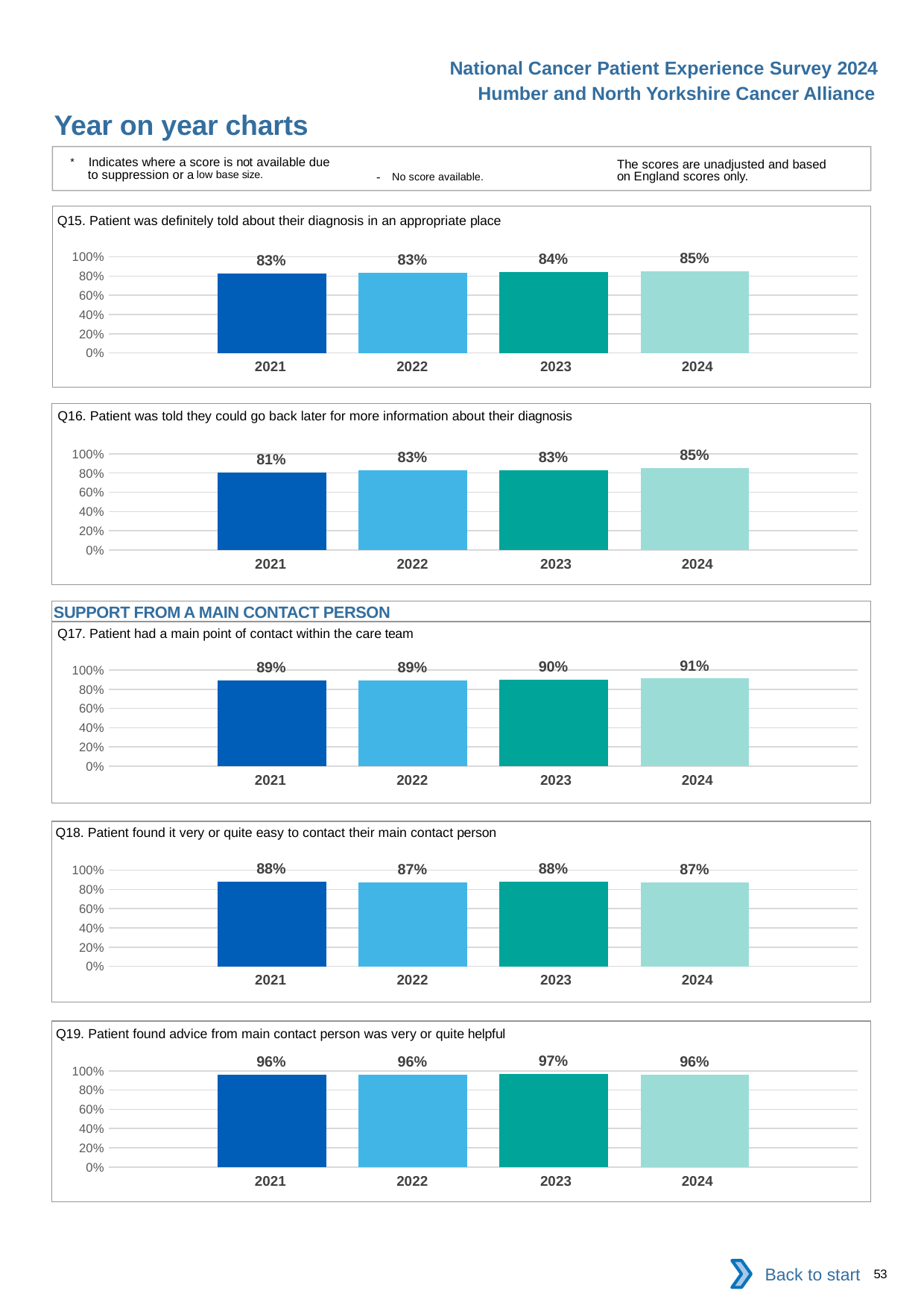
In the Q19 chart, which year has the highest value? 2023 In the Q16 chart, which year has the highest value? 2024 In the Q17 chart, what is the value for 2023? 90% In the Q16 chart, what is the difference between the 2024 and 2021 values? 4 percentage points In the Q15 chart, what is the value for 2024? 85% In the Q17 chart, which year has the highest value? 2024 In the Q16 chart, do the values generally rise or fall from 2021 to 2024? Rise In the Q16 chart, what is the value for 2021? 81% How many years are shown on the x axis of the Q15 chart? 4 In the Q19 chart, what is the difference between the 2023 and 2024 values? 1 percentage point In the Q18 chart, what is the value for 2022? 87% What kind of chart is the Q18 chart? Bar chart